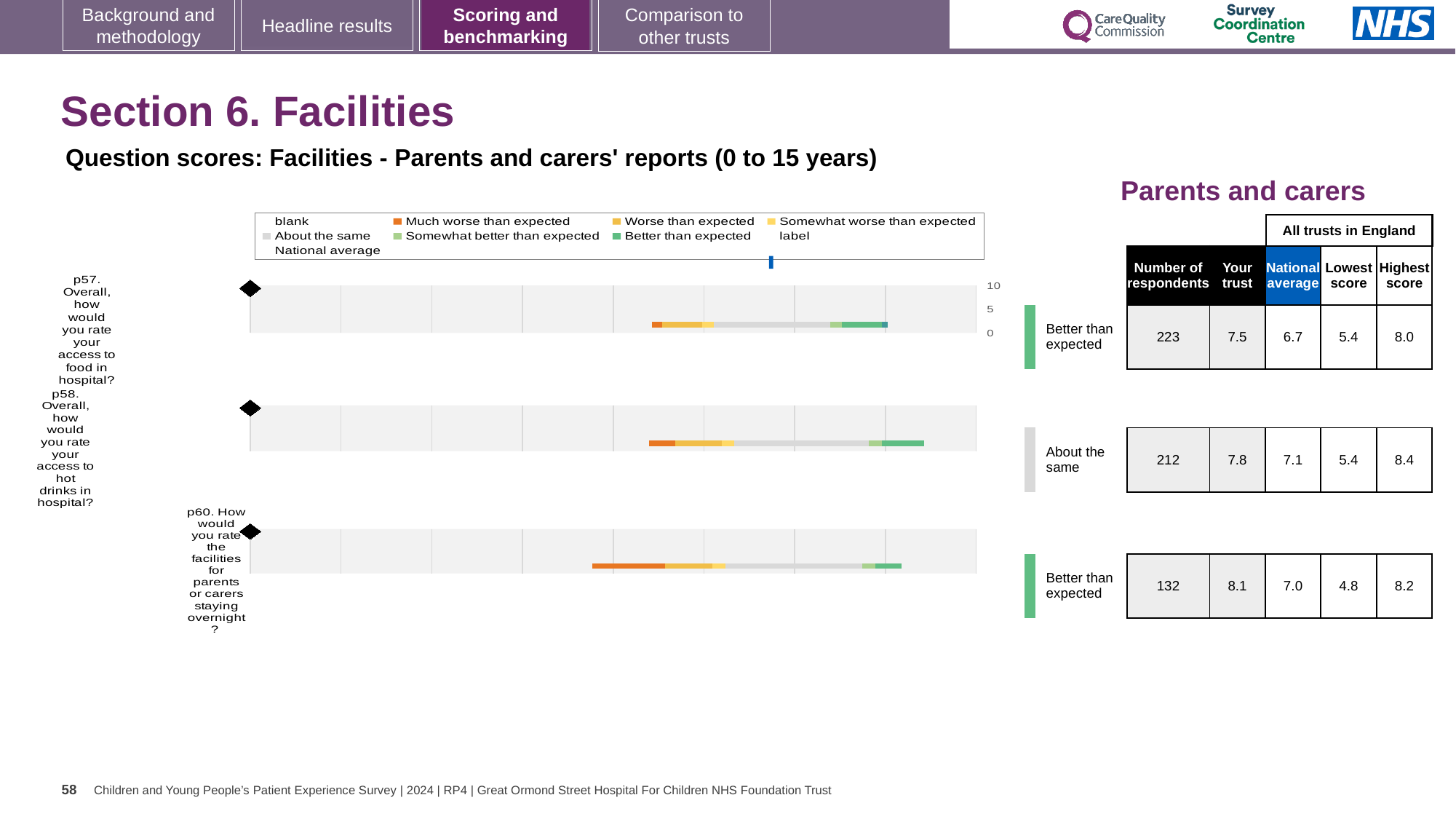
Which of the three questions has the fewest respondents? p60 (facilities for parents or carers staying overnight) What benchmark category is shown for p58 (access to hot drinks in hospital)? About the same Which has the larger 'Your trust' score: p57 (access to food) or p58 (access to hot drinks)? p58 (access to hot drinks) What is the lowest score across all trusts in England for p60 (facilities for parents or carers staying overnight)? 4.8 What kind of chart is used to show the question scores on this slide? Bar chart How many questions are plotted on the slide? 3 What is the national average score for p58 (Overall, how would you rate your access to hot drinks in hospital?)? 7.1 How many respondents answered p60 (How would you rate the facilities for parents or carers staying overnight?)? 132 What is the highest score across all trusts in England for p58 (access to hot drinks)? 8.4 Which of the three questions has the highest 'Your trust' score? p60 (facilities for parents or carers staying overnight) What is the difference between the 'Your trust' score and the national average for p57 (access to food in hospital)? 0.8 What is the 'Your trust' score for p57 (Overall, how would you rate your access to food in hospital?)? 7.5